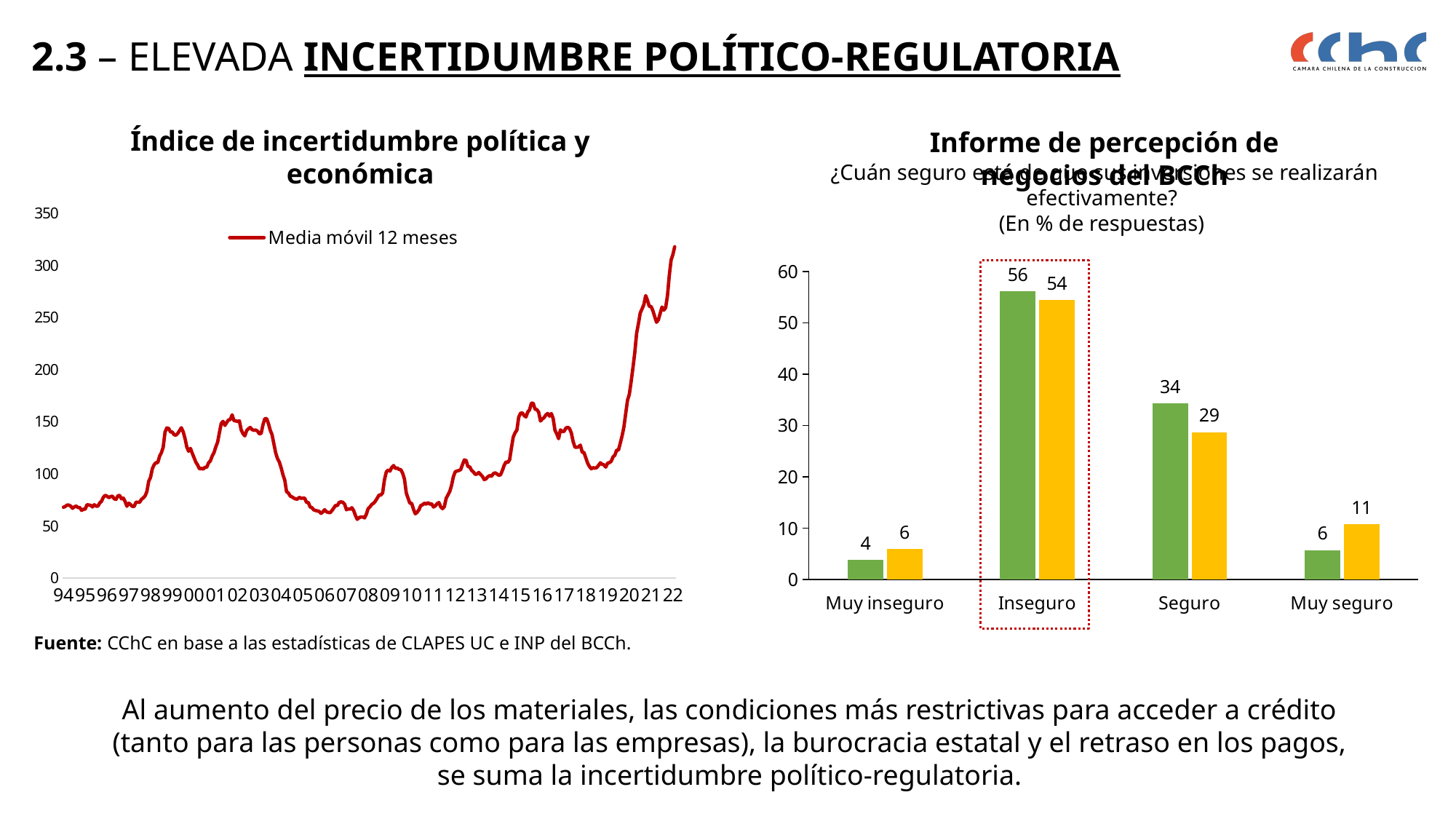
How many categories are shown on the x axis of the 'Informe de percepción de negocios del BCCh' chart? 4 In the 'Informe de percepción de negocios del BCCh' chart, what is the difference between the green and yellow bars for 'Seguro'? 5 In the 'Informe de percepción de negocios del BCCh' chart, what is the value of the green bar for 'Inseguro'? 56 In the 'Informe de percepción de negocios del BCCh' chart, which category has the lowest yellow bar? Muy inseguro What kind of chart is the 'Informe de percepción de negocios del BCCh' chart on the right? bar chart In the 'Índice de incertidumbre política y económica' chart, is the value at the end of the series (22) greater or less than 300? greater In the 'Índice de incertidumbre política y económica' chart, does the line rise or fall between 19 and 22? rises What is the legend entry shown on the 'Índice de incertidumbre política y económica' chart? Media móvil 12 meses In the 'Informe de percepción de negocios del BCCh' chart, for 'Muy seguro', which bar is larger, the green or the yellow one? yellow In the 'Informe de percepción de negocios del BCCh' chart, what is the value of the yellow bar for 'Seguro'? 29 What kind of chart is the 'Índice de incertidumbre política y económica' chart on the left? line chart In the 'Informe de percepción de negocios del BCCh' chart, which category has the highest green bar? Inseguro